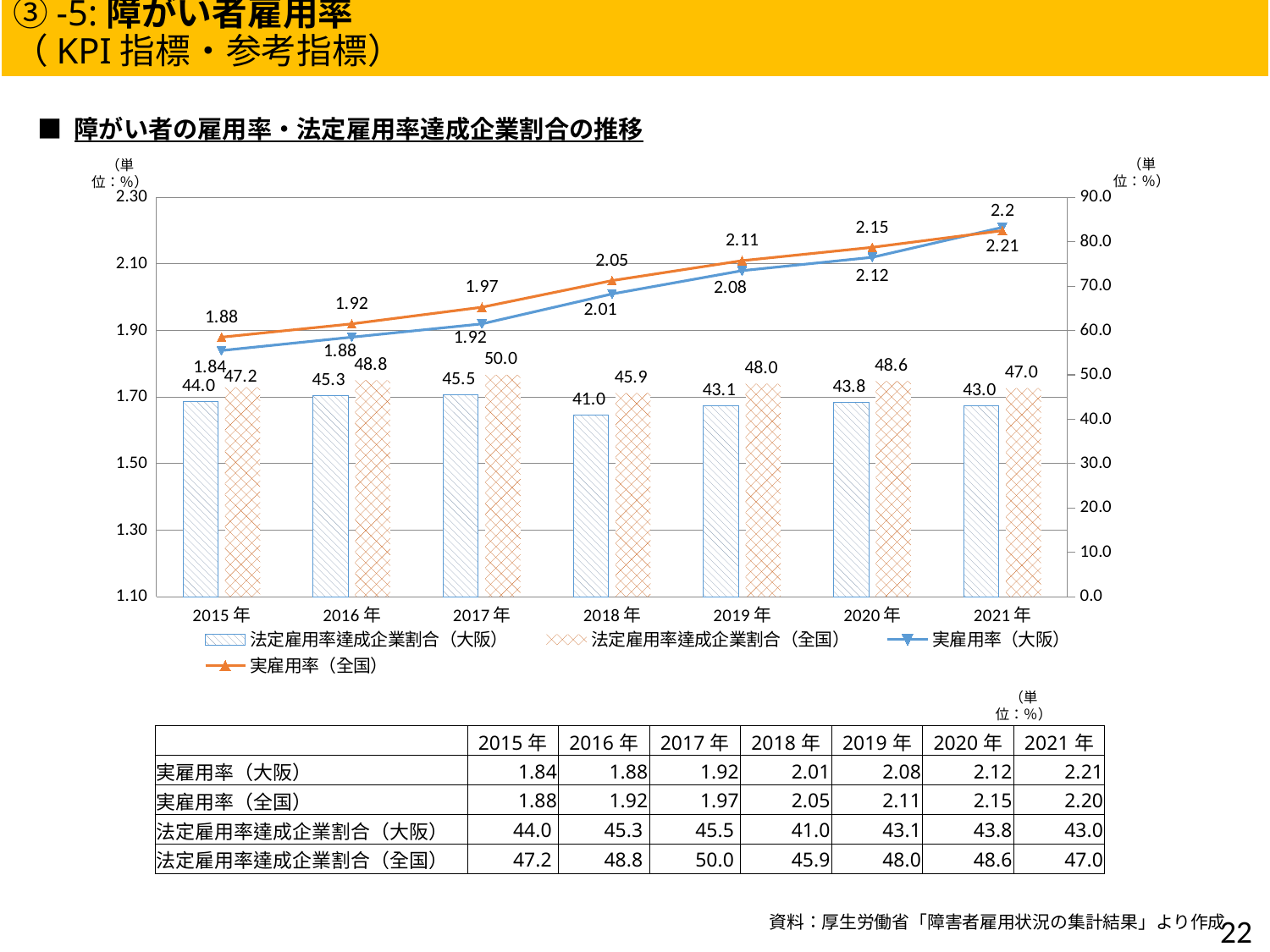
What is the difference between 法定雇用率達成企業割合（全国） and 法定雇用率達成企業割合（大阪） in 2019年? 4.9 What is the difference between 実雇用率（全国） and 実雇用率（大阪） in 2015年? 0.04 What kind of chart is shown on the slide? Combination bar and line chart What is the value of 実雇用率（大阪） in 2018年? 2.01 What is the value of 法定雇用率達成企業割合（全国） in 2017年? 50.0 In 2021年, which is larger: 実雇用率（大阪） or 実雇用率（全国）? 実雇用率（大阪） What is the value of 法定雇用率達成企業割合（大阪） in 2020年? 43.8 In which year is 法定雇用率達成企業割合（全国） lowest? 2018年 In which year is 法定雇用率達成企業割合（大阪） highest? 2017年 Does 実雇用率（全国） rise or fall from 2015年 to 2021年? Rises How many years are shown on the x axis of the chart? 7 How many series does the chart legend list? 4